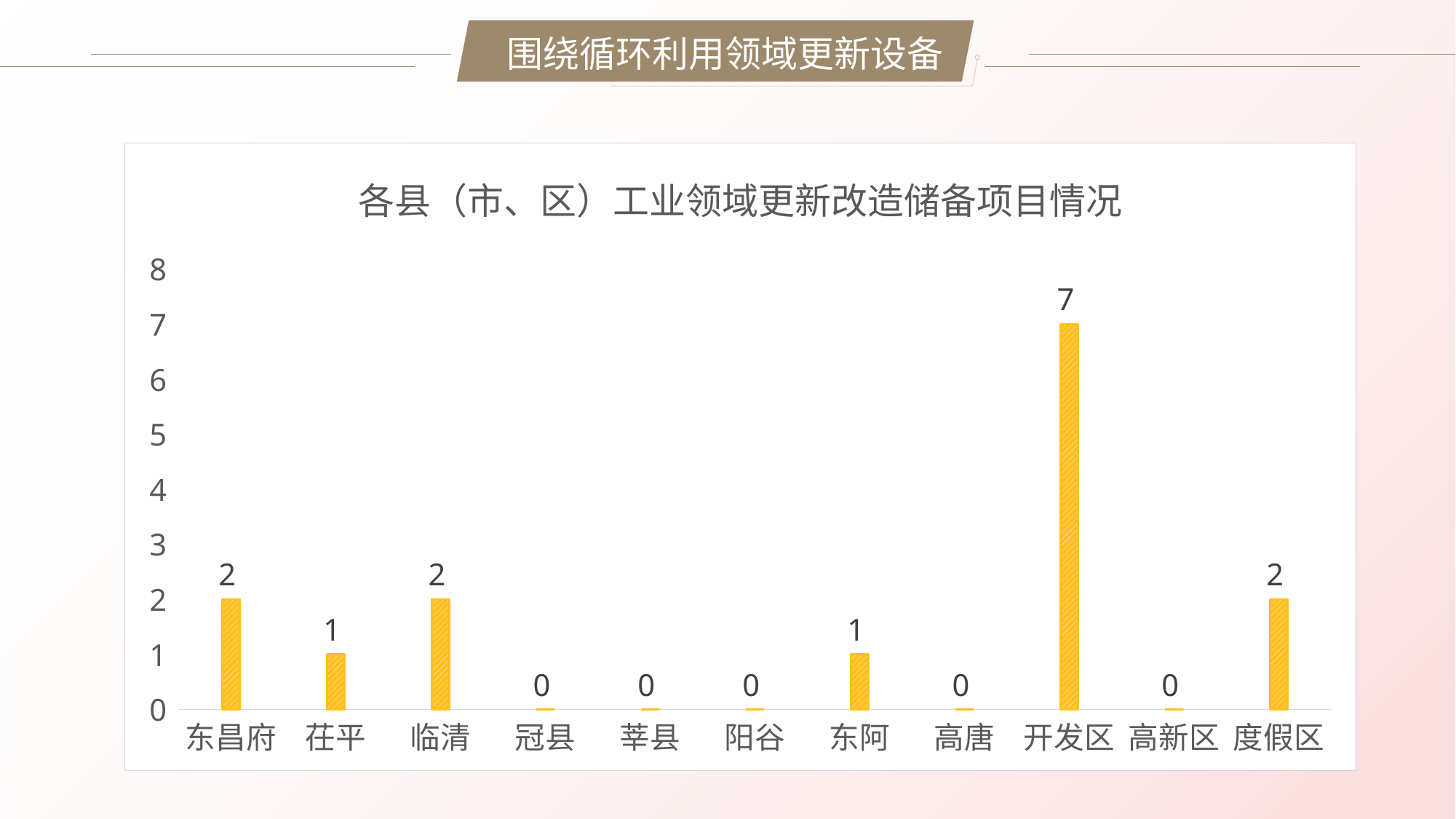
Is the value for 开发区 greater or less than 5? greater What kind of chart is shown on the slide? bar chart How many categories are shown on the x axis? 11 What is the value for 开发区? 7 Which is larger, the value for 临清 or the value for 东阿? 临清 What is the value for 茌平? 1 How many categories have a value of 0? 5 What is the difference between the values for 开发区 and 东昌府? 5 What is the value for 度假区? 2 What is the value for 高新区? 0 What is the title of the chart? 各县（市、区）工业领域更新改造储备项目情况 Which category has the highest value? 开发区